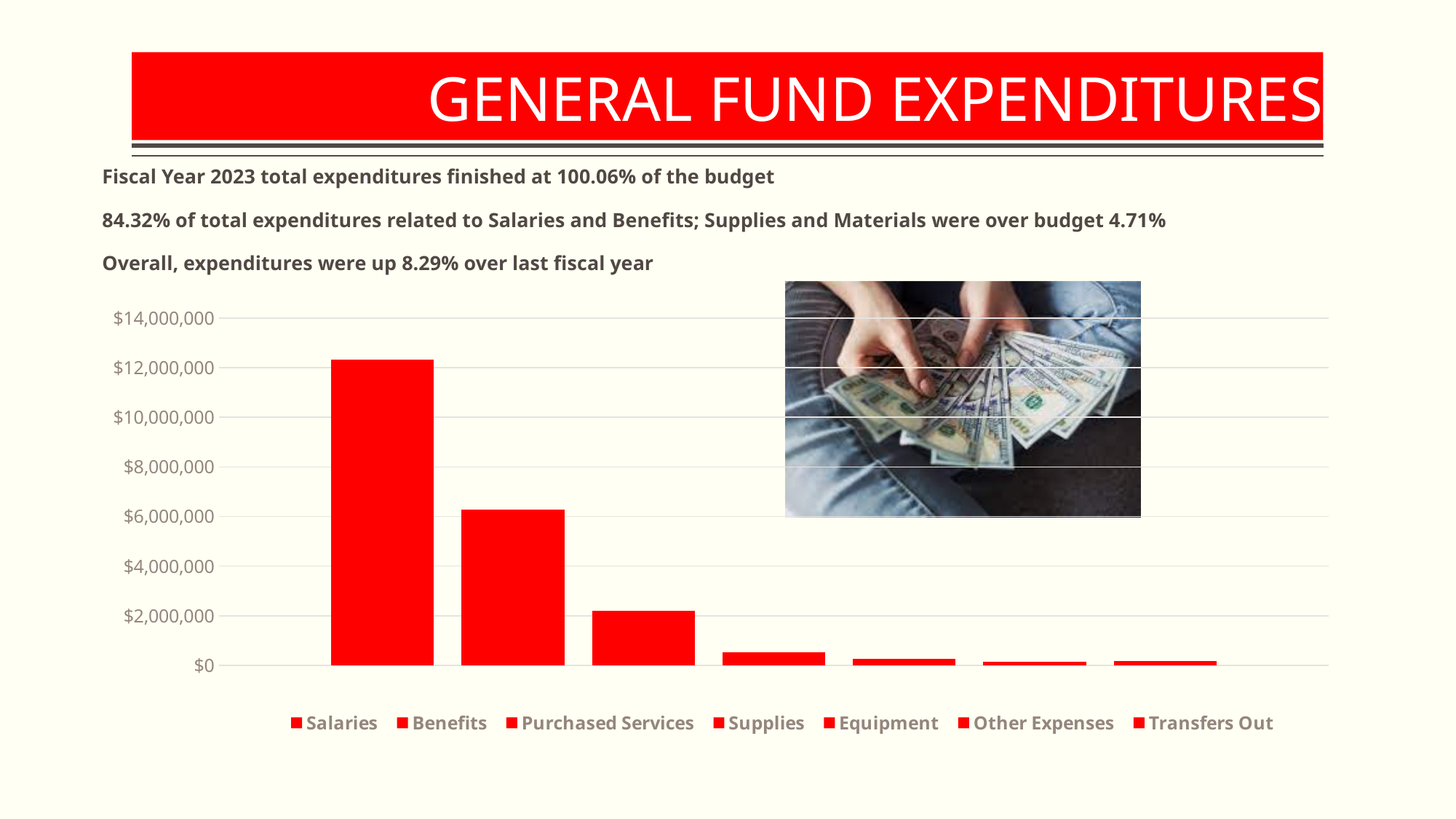
What colour are the bars in the chart? red Is the value for Supplies greater or less than $2,000,000? less Is the value for Salaries greater or less than $12,000,000? greater Is the value for Benefits greater or less than $8,000,000? less How many categories (bars) are plotted in the chart? 7 Do the bar values generally rise or fall from left to right across the chart? fall Which category has the highest value in the chart? Salaries How many entries does the chart legend list? 7 Which is larger, the value for Salaries or the value for Benefits? Salaries Which is larger, the value for Purchased Services or the value for Supplies? Purchased Services What kind of chart is shown on the slide? bar chart